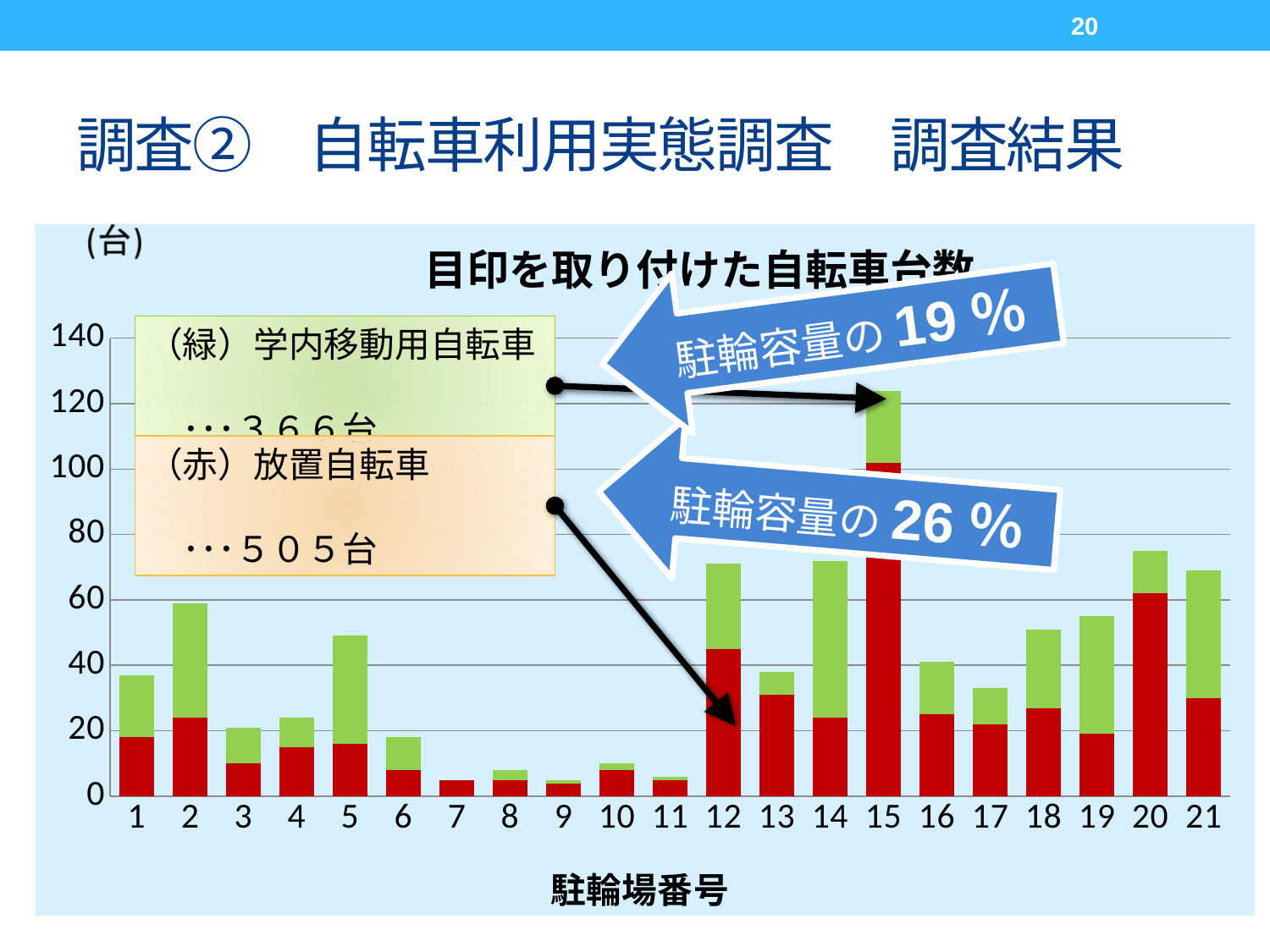
Is the total bar for parking lot 7 greater or less than 20? less Is the total bar for parking lot 20 greater or less than 60? greater Which parking lot number has the tallest bar? 15 Which bar is taller, parking lot 2 or parking lot 3? 2 How many parking lot numbers (駐輪場番号) are shown on the x axis? 21 According to the legend box, how many 学内移動用自転車 (green) were counted in total? ３６６台 How many series are stacked in each bar? 2 What kind of chart is shown on the slide? stacked bar chart According to the legend box, how many 放置自転車 (red) were counted in total? ５０５台 Which parking lot number has the largest red (放置自転車) portion? 15 Is the total bar for parking lot 15 greater or less than 100? greater